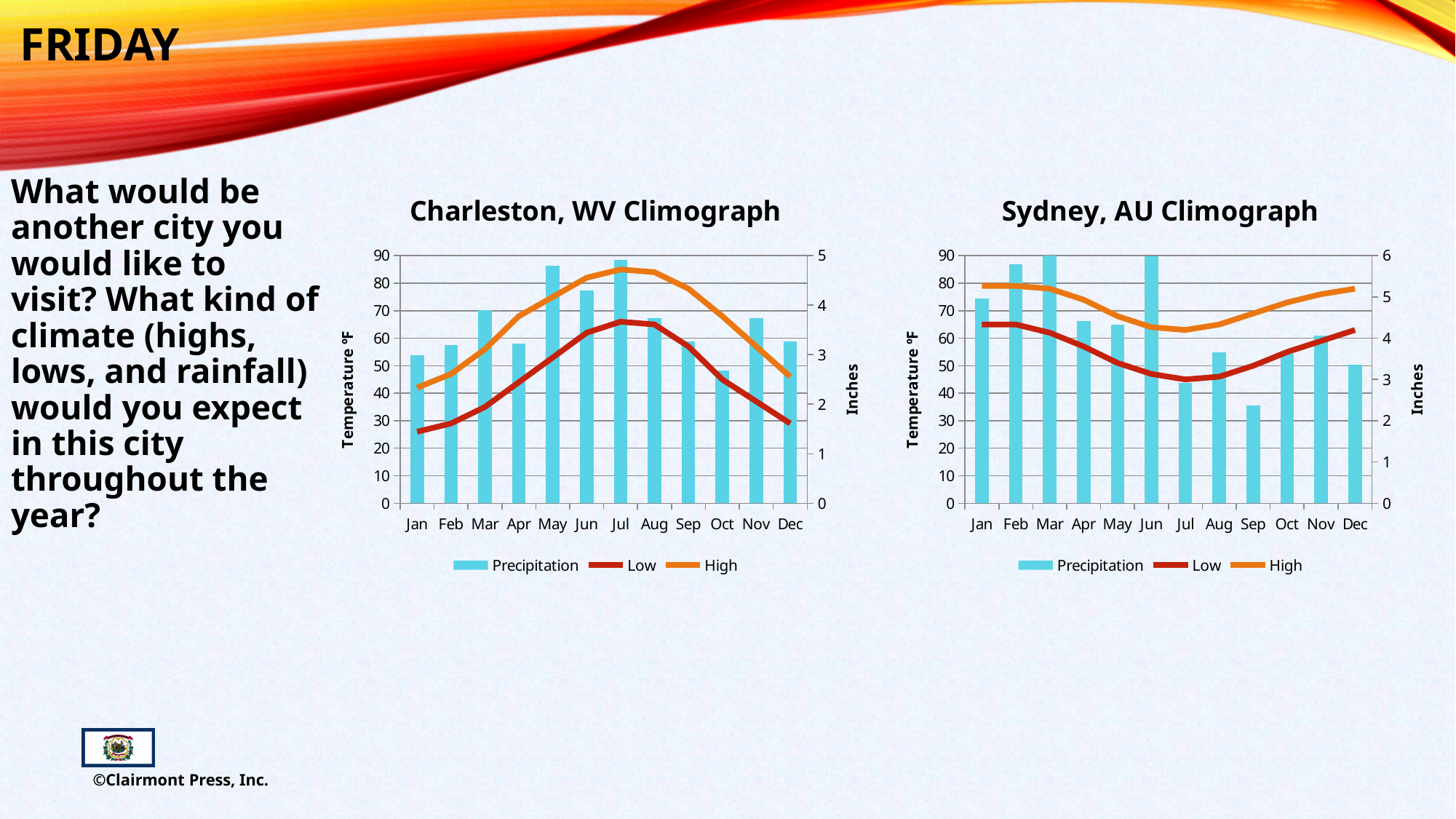
On the Sydney, AU Climograph, in which month is the Precipitation bar the lowest? Sep On the Sydney, AU Climograph, does the High line rise or fall from Jan to Jul? fall On the Charleston, WV Climograph, in which month is the Low line at its lowest? Jan On the Sydney, AU Climograph, what is the label of the right-hand vertical axis? Inches On the Charleston, WV Climograph, how many months are shown on the x axis? 12 On the Charleston, WV Climograph, in which month does the High line reach its peak? Jul On the Charleston, WV Climograph, what kind of chart is used? Combined bar and line chart On the Sydney, AU Climograph, how many series does the legend list? 3 On the Charleston, WV Climograph, is the Low value for Jan greater or less than 30? less On the Charleston, WV Climograph, does the High line rise or fall from Jan to Jul? rise On the Charleston, WV Climograph, is the High value for Jul greater or less than 80? greater On the Sydney, AU Climograph, is the Precipitation value for Sep greater or less than 3 inches? less